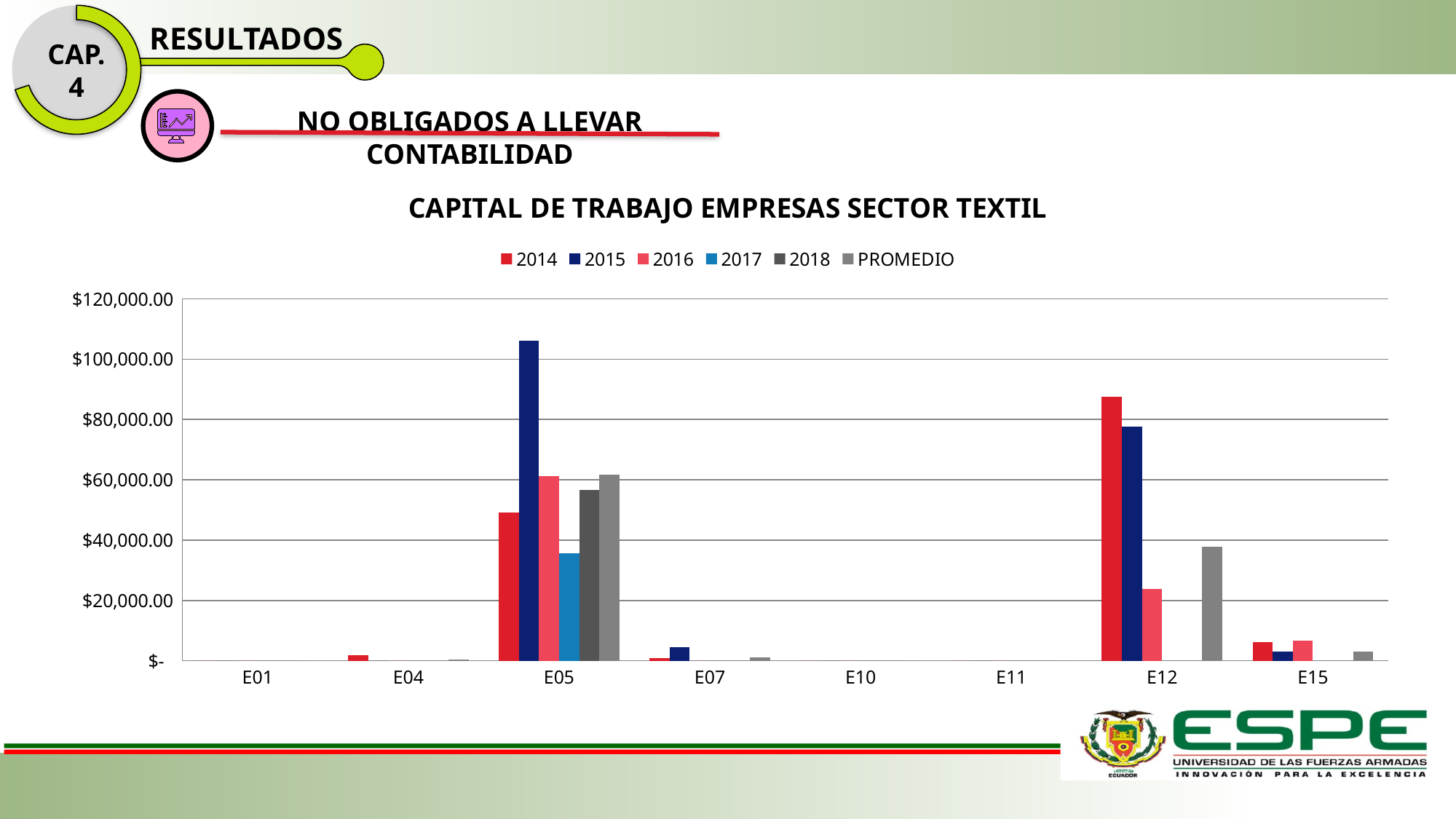
What type of chart is shown on the slide? bar chart Which is larger: the 2015 value for E05 or the 2014 value for E12? the 2015 value for E05 How many series does the legend list? 6 How many categories are shown on the x axis? 8 Which category has the highest value for the 2015 series? E05 Which category has the highest value for the 2014 series? E12 Is the 2017 value for E05 greater or less than $40,000.00? less What is the title of the chart? CAPITAL DE TRABAJO EMPRESAS SECTOR TEXTIL Is the 2014 value for E12 greater or less than $80,000.00? greater Is the PROMEDIO value for E12 greater or less than $40,000.00? less Which is larger for E12: the 2014 value or the 2015 value? 2014